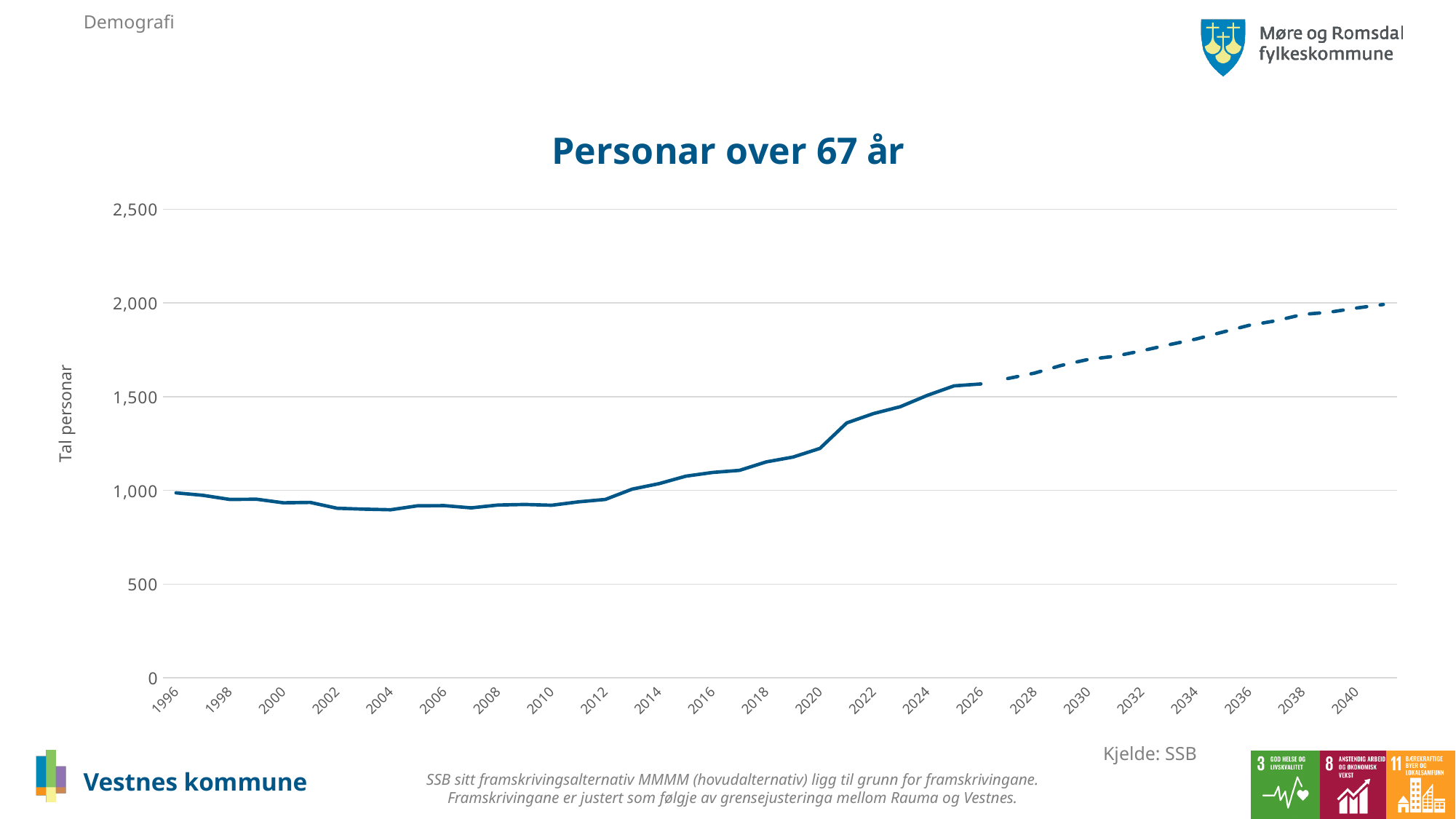
Is the value for 2020 greater or less than 1,000? greater Which is larger, the value for 1996 or the value for 2004? 1996 Do the values rise or fall along the x axis from 2012 to 2040? rise Is the value for 2020 greater or less than 1,500? less Is the value for 2012 greater or less than 1,000? less What is the title of the chart? Personar over 67 år What is the label on the vertical axis of the chart? Tal personar What kind of chart is shown on the slide? line chart Which is larger, the value for 2010 or the value for 2020? 2020